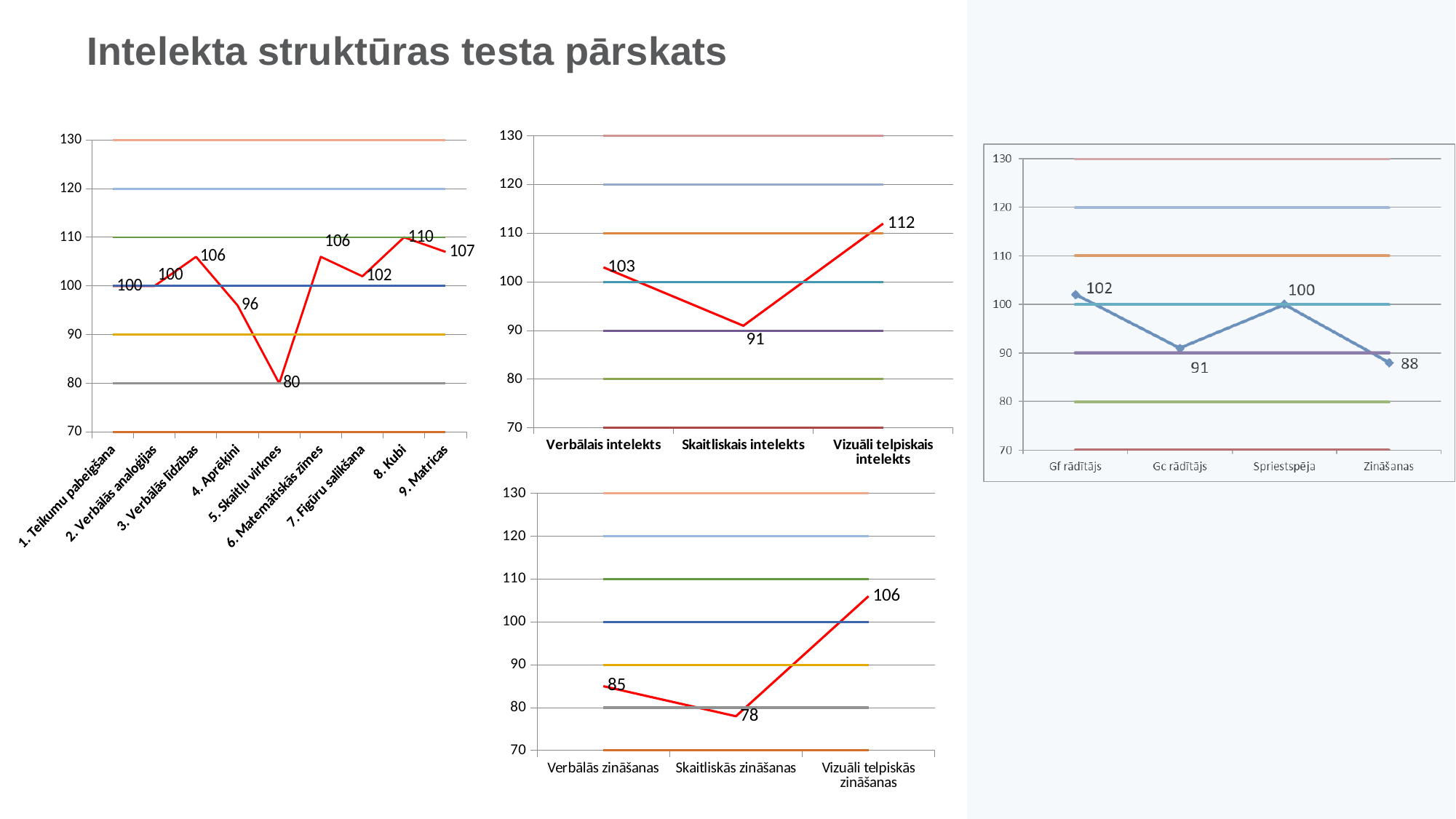
In the left chart, what is the value for 5. Skaitļu virknes? 80 What kind of chart is the left chart? Line chart In the top middle chart, what is the value for Vizuāli telpiskais intelekts? 112 In the bottom middle chart, what is the value for Skaitliskās zināšanas? 78 In the left chart, which category has the highest value? 8. Kubi In the right chart, how many categories are plotted on the x axis? 4 In the left chart, how many categories are plotted on the x axis? 9 In the right chart, which is larger, Gf rādītājs or Gc rādītājs? Gf rādītājs In the left chart, what is the difference between the values for 8. Kubi and 4. Aprēķini? 14 In the top middle chart, which category has the lowest value? Skaitliskais intelekts In the bottom middle chart, what is the difference between Vizuāli telpiskās zināšanas and Verbālās zināšanas? 21 In the right chart, what is the value for Zināšanas? 88